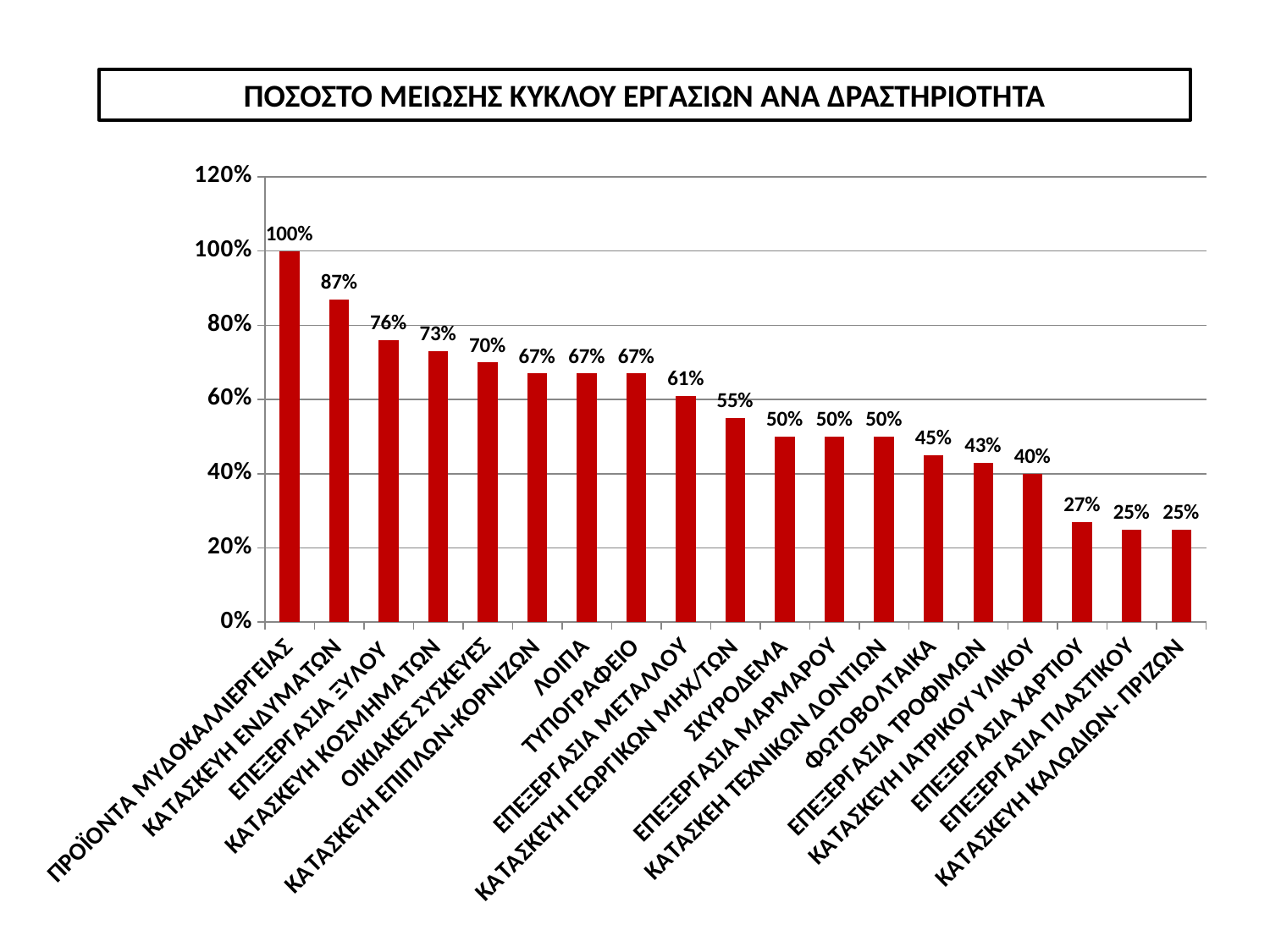
What is the lowest value shown in the chart? 25% Do the values rise or fall from left to right along the x axis? fall Is the value for ΚΑΤΑΣΚΕΥΗ ΓΕΩΡΓΙΚΩΝ ΜΗΧ/ΤΩΝ greater or less than 60%? less What is the value for ΚΑΤΑΣΚΕΥΗ ΕΝΔΥΜΑΤΩΝ? 87% How many categories are shown in the chart? 19 Which category has the highest value? ΠΡΟΪΟΝΤΑ ΜΥΔΟΚΑΛΛΙΕΡΓΕΙΑΣ What is the difference between the values for ΕΠΕΞΕΡΓΑΣΙΑ ΞΥΛΟΥ and ΕΠΕΞΕΡΓΑΣΙΑ ΜΕΤΑΛΛΟΥ? 15% What is the value for ΦΩΤΟΒΟΛΤΑΙΚΑ? 45% Which is larger, the value for ΟΙΚΙΑΚΕΣ ΣΥΣΚΕΥΕΣ or the value for ΣΚΥΡΟΔΕΜΑ? ΟΙΚΙΑΚΕΣ ΣΥΣΚΕΥΕΣ What is the title of the chart? ΠΟΣΟΣΤΟ ΜΕΙΩΣΗΣ ΚΥΚΛΟΥ ΕΡΓΑΣΙΩΝ ΑΝΑ ΔΡΑΣΤΗΡΙΟΤΗΤΑ What type of chart is shown on the slide? Bar chart What is the value for ΕΠΕΞΕΡΓΑΣΙΑ ΧΑΡΤΙΟΥ? 27%